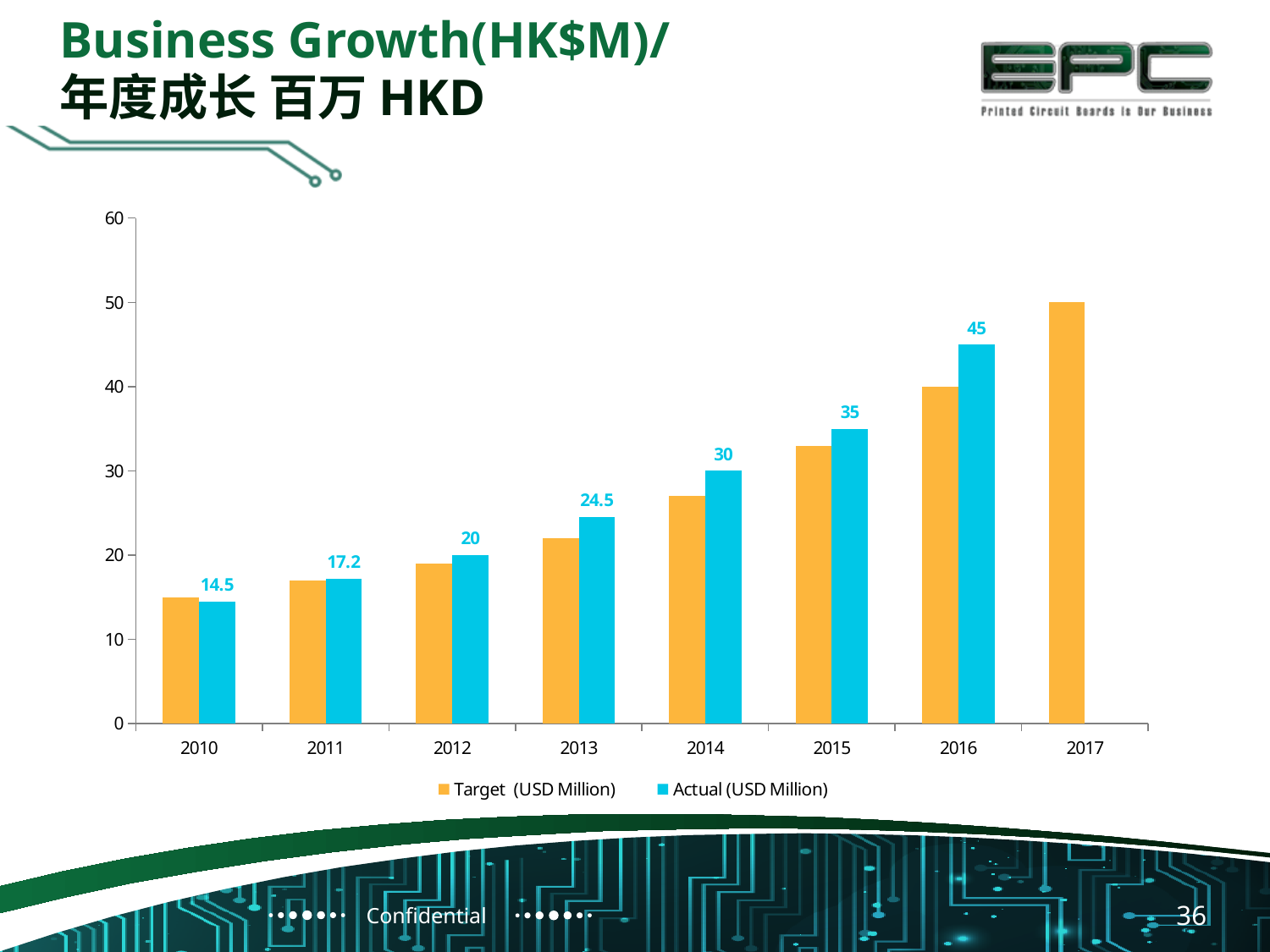
Is the Target value for 2010 greater or less than 20? less What is the Actual (USD Million) value for 2013? 24.5 Which is larger, the Actual value for 2014 or the Actual value for 2013? 2014 How many series does the legend list? 2 How many years are shown on the x axis? 8 Do the Actual values rise or fall from 2010 to 2016? rise Which year has the lowest Actual (USD Million) value? 2010 What is the Actual (USD Million) value for 2011? 17.2 Is the Target value for 2017 greater or less than 40? greater What is the Actual (USD Million) value for 2015? 35 Which year has the highest Actual (USD Million) value? 2016 What is the difference between the Actual values for 2016 and 2015? 10